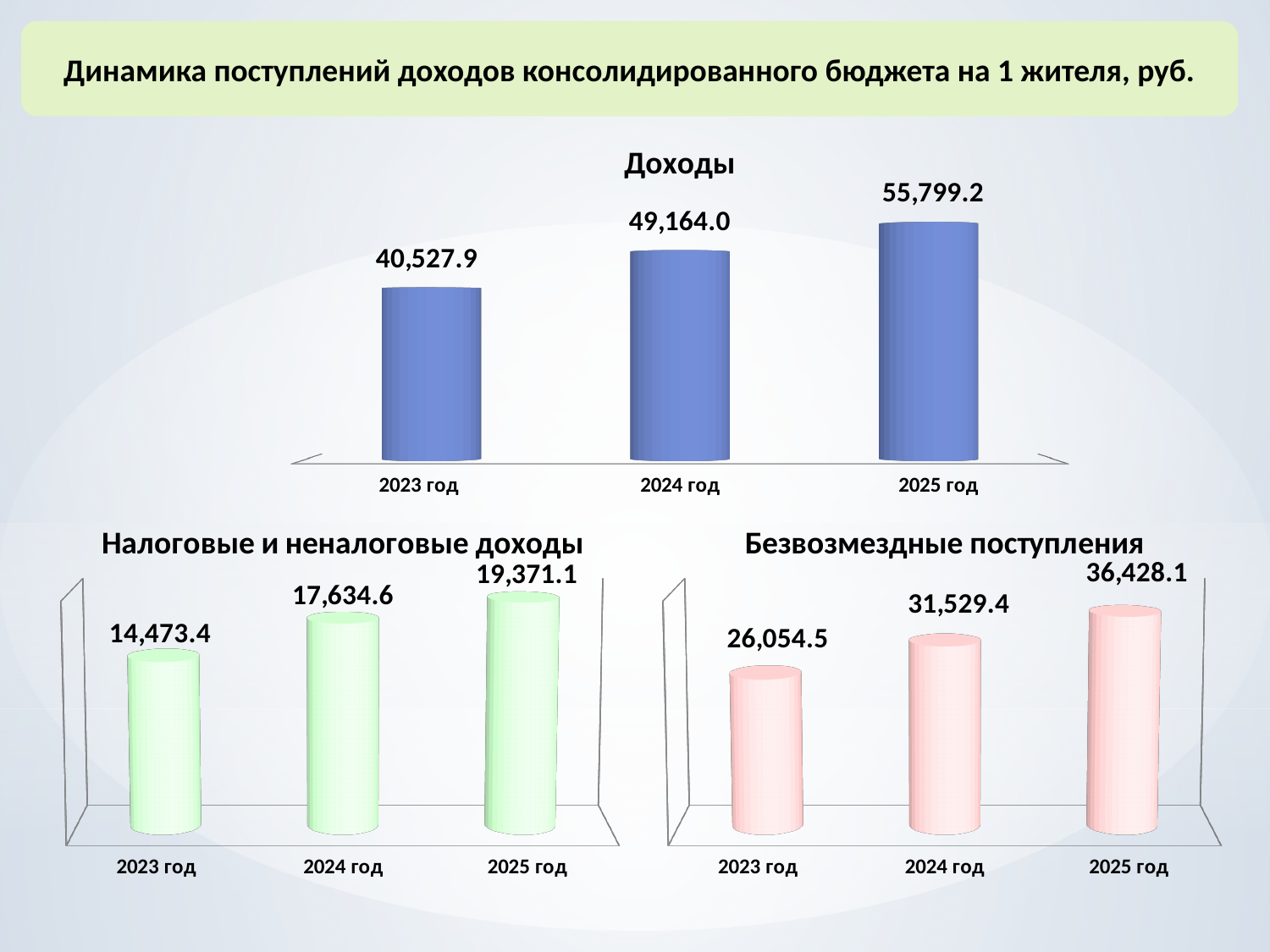
In the "Доходы" chart, what is the value for 2024 год? 49,164.0 How many categories (years) are shown in the "Доходы" chart? 3 In the "Безвозмездные поступления" chart, what is the difference between the 2024 год and 2023 год values? 5,474.9 In the "Безвозмездные поступления" chart, what is the value for 2025 год? 36,428.1 What type of chart is the "Доходы" chart? bar chart In the "Доходы" chart, which year has the highest value? 2025 год In the "Безвозмездные поступления" chart, do the values rise or fall from 2023 год to 2025 год? rise In the "Доходы" chart, what is the difference between the 2025 год and 2023 год values? 15,271.3 In the "Налоговые и неналоговые доходы" chart, what is the difference between the 2025 год and 2024 год values? 1,736.5 In the "Налоговые и неналоговые доходы" chart, which year has the lowest value? 2023 год Which is larger: the 2024 год value in the "Налоговые и неналоговые доходы" chart or the 2024 год value in the "Безвозмездные поступления" chart? Безвозмездные поступления In the "Налоговые и неналоговые доходы" chart, what is the value for 2023 год? 14,473.4